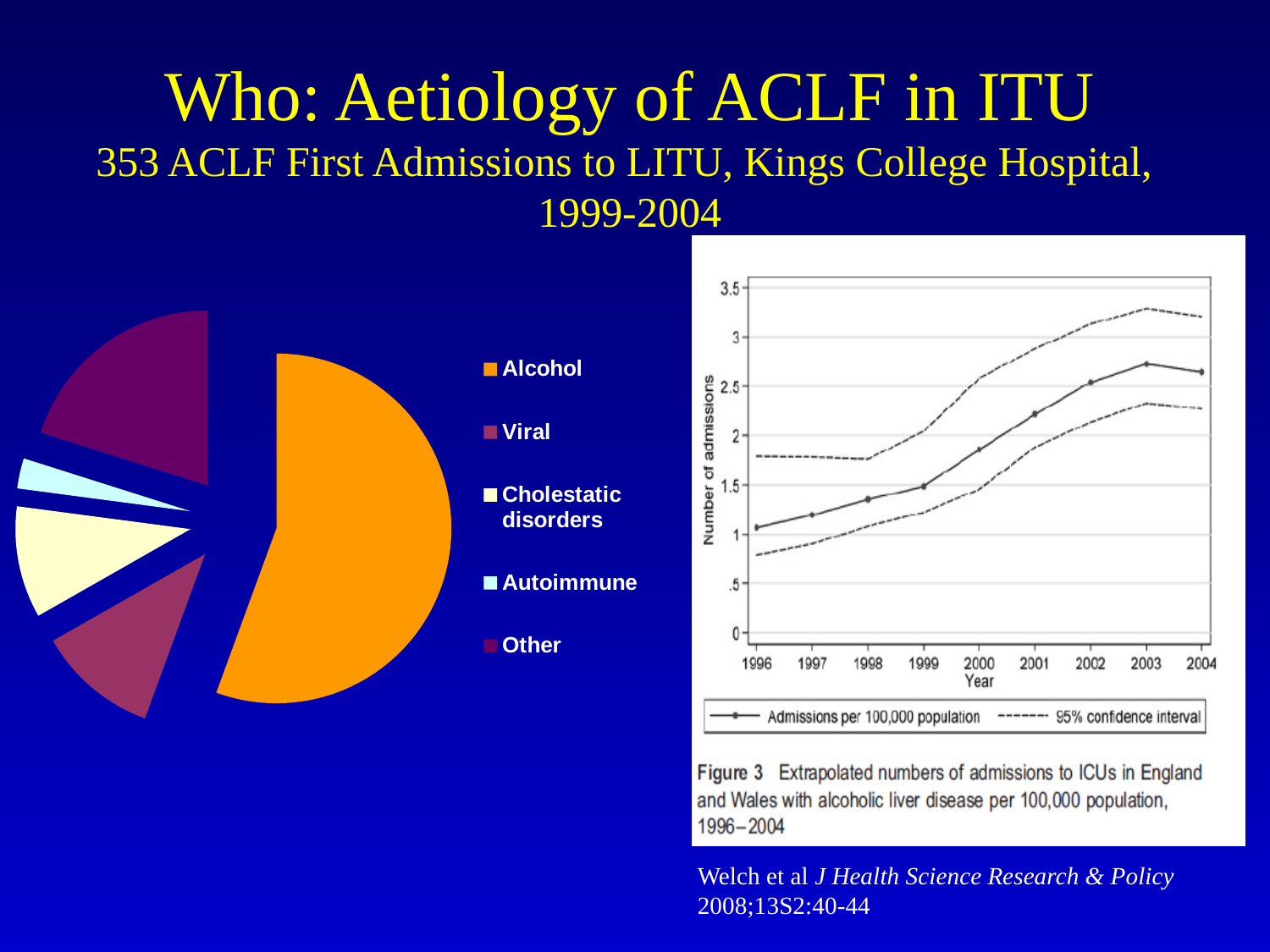
On the pie chart on the left, which slice is larger, Alcohol or Viral? Alcohol On the pie chart on the left, which category has the smallest slice? Autoimmune What kind of chart is the chart on the left of the slide? Pie chart In Figure 3 on the right, do admissions per 100,000 population generally rise or fall from 1996 to 2003? Rise In Figure 3 on the right, is the admissions per 100,000 population value for 2003 greater or less than 2.5? greater In Figure 3 on the right, in which year is the admissions per 100,000 population line at its highest? 2003 On the pie chart on the left, which category has the largest slice? Alcohol What kind of chart is Figure 3 on the right of the slide? Line chart On the pie chart on the left, which slice is larger, Cholestatic disorders or Autoimmune? Cholestatic disorders On the pie chart on the left, how many categories does the legend list? 5 In Figure 3 on the right, how many years are shown on the x axis? 9 In Figure 3 on the right, how many series does the legend list? 2